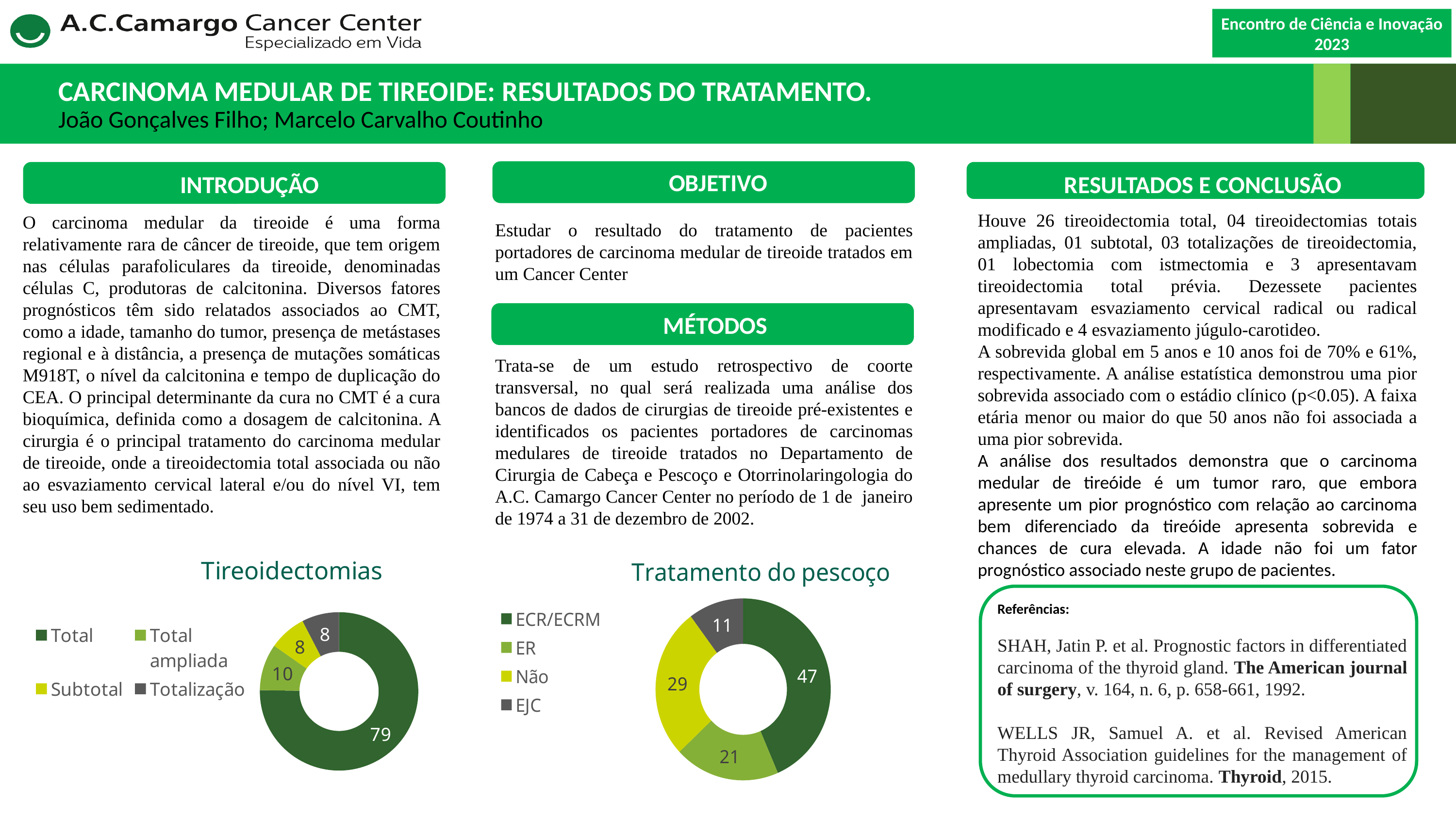
In the 'Tratamento do pescoço' chart, what is the value for ECR/ECRM? 47 In the 'Tireoidectomias' chart, what is the value for Total? 79 In the 'Tireoidectomias' chart, how many categories does the legend list? 4 What kind of chart is the 'Tireoidectomias' chart? Doughnut chart In the 'Tratamento do pescoço' chart, what is the value for Não? 29 In the 'Tireoidectomias' chart, which category has the highest value? Total In the 'Tratamento do pescoço' chart, what is the difference between ECR/ECRM and Não? 18 In the 'Tireoidectomias' chart, what is the difference between Total and Total ampliada? 69 In the 'Tratamento do pescoço' chart, which is larger, ER or Não? Não In the 'Tratamento do pescoço' chart, which colour represents EJC? Gray In the 'Tireoidectomias' chart, what is the value for Total ampliada? 10 In the 'Tratamento do pescoço' chart, which category has the lowest value? EJC